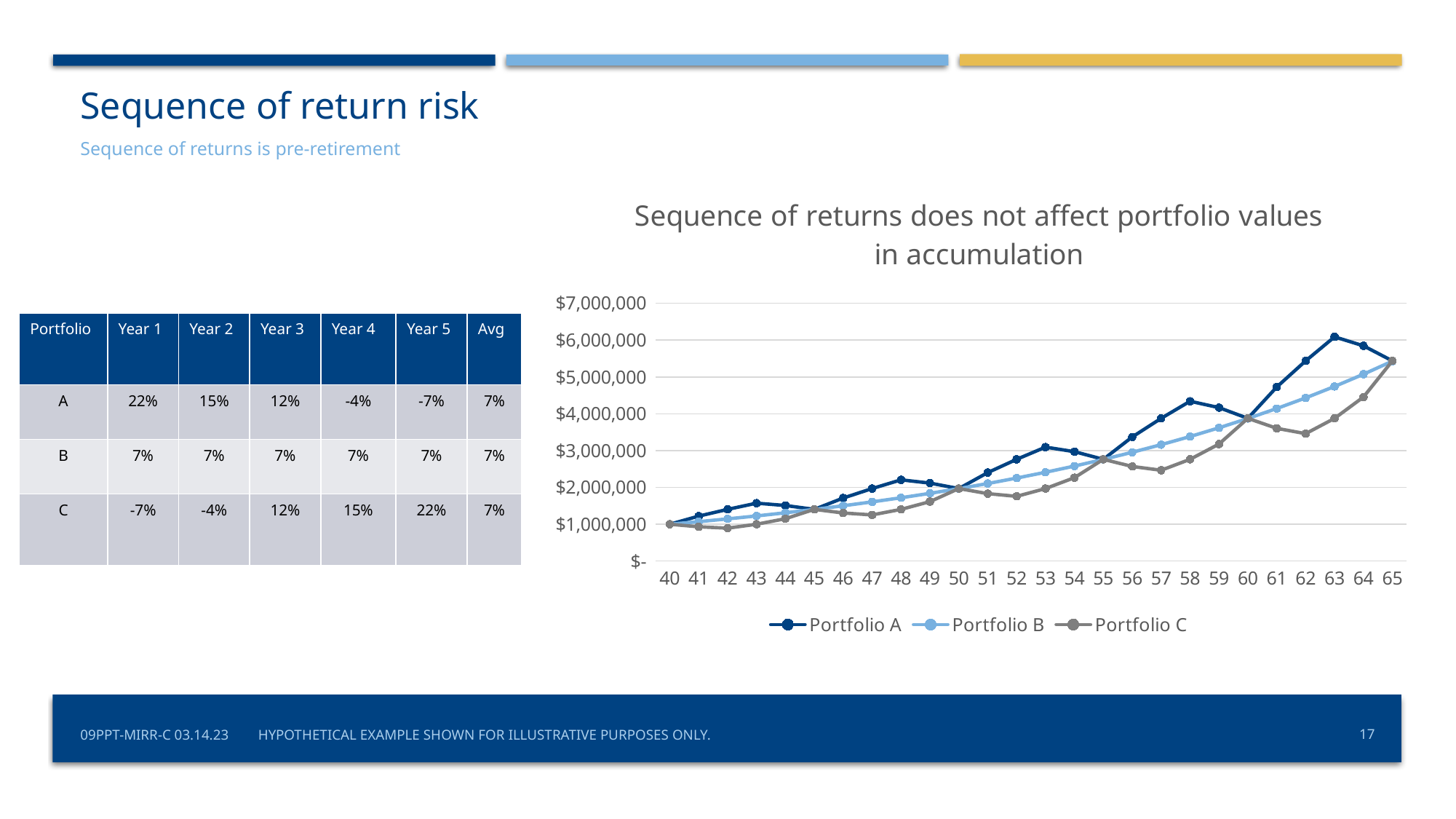
Is the value for Portfolio A at age 58 greater or less than $4,000,000? greater What is the value of Portfolio B at age 40? $1,000,000 Which portfolio has the highest value at age 63? Portfolio A At age 58, which is larger: Portfolio A or Portfolio C? Portfolio A What is the title of the chart? Sequence of returns does not affect portfolio values in accumulation How many series does the chart legend list? 3 Is the value for Portfolio B at age 65 greater or less than $5,000,000? greater Does the Portfolio B line rise or fall from age 40 to age 65? rise Which portfolio has the lowest value at age 57? Portfolio C What kind of chart is shown on the slide? line chart Is the value for Portfolio C at age 62 greater or less than $4,000,000? less How many age points are plotted along the x axis of the chart? 26